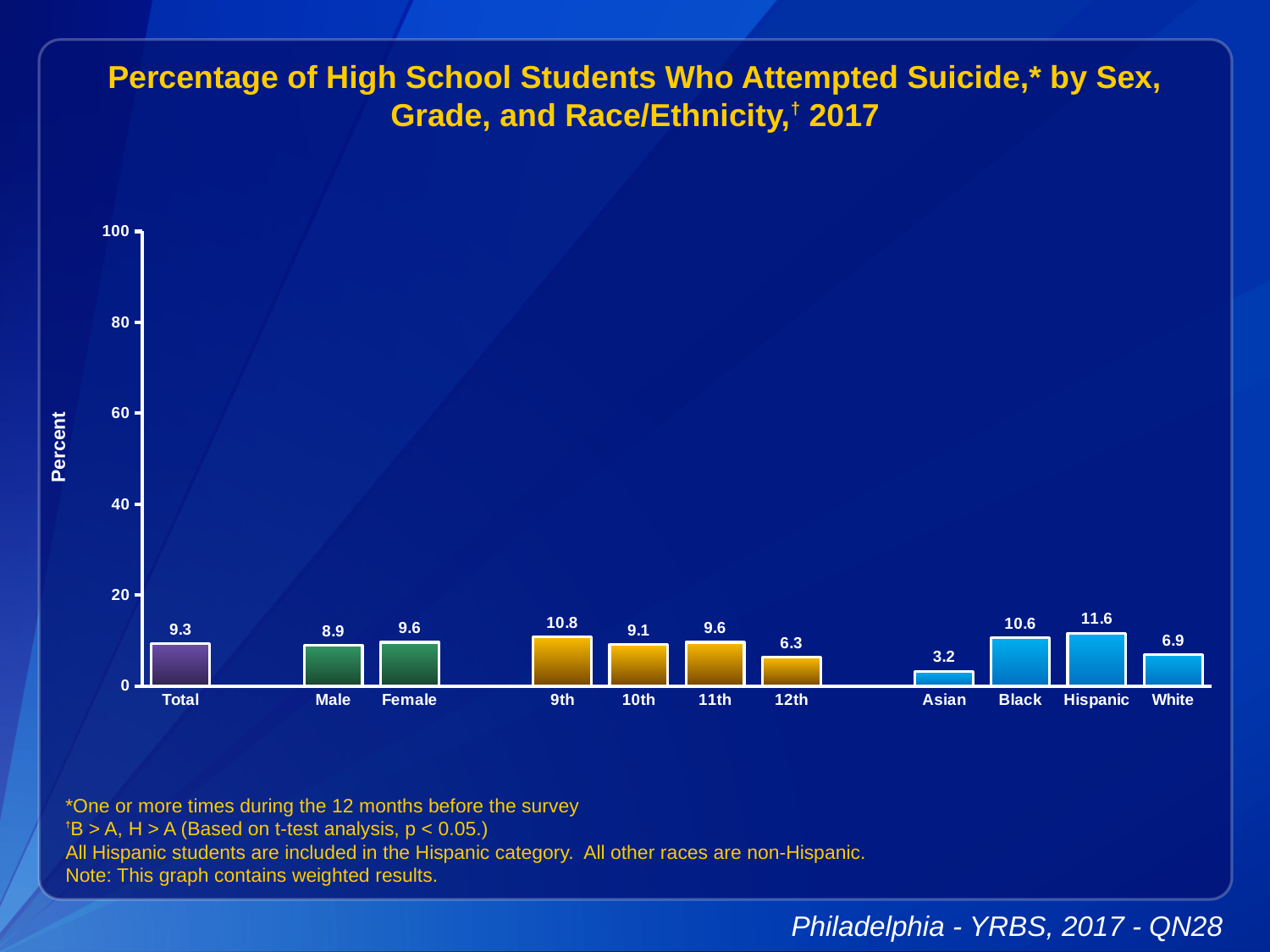
What kind of chart is this? bar chart What is the value for Female? 9.6 What is the label on the y axis? Percent What is the value for Asian students? 3.2 How many categories are shown on the x axis? 11 What is the value for Total? 9.3 Which is larger, the value for Black or the value for White? Black What is the difference between the values for 9th and 12th grade? 4.5 Which category has the highest value? Hispanic Is the value for Hispanic greater or less than 20? less Which category has the lowest value? Asian What is the difference between the values for Female and Male? 0.7